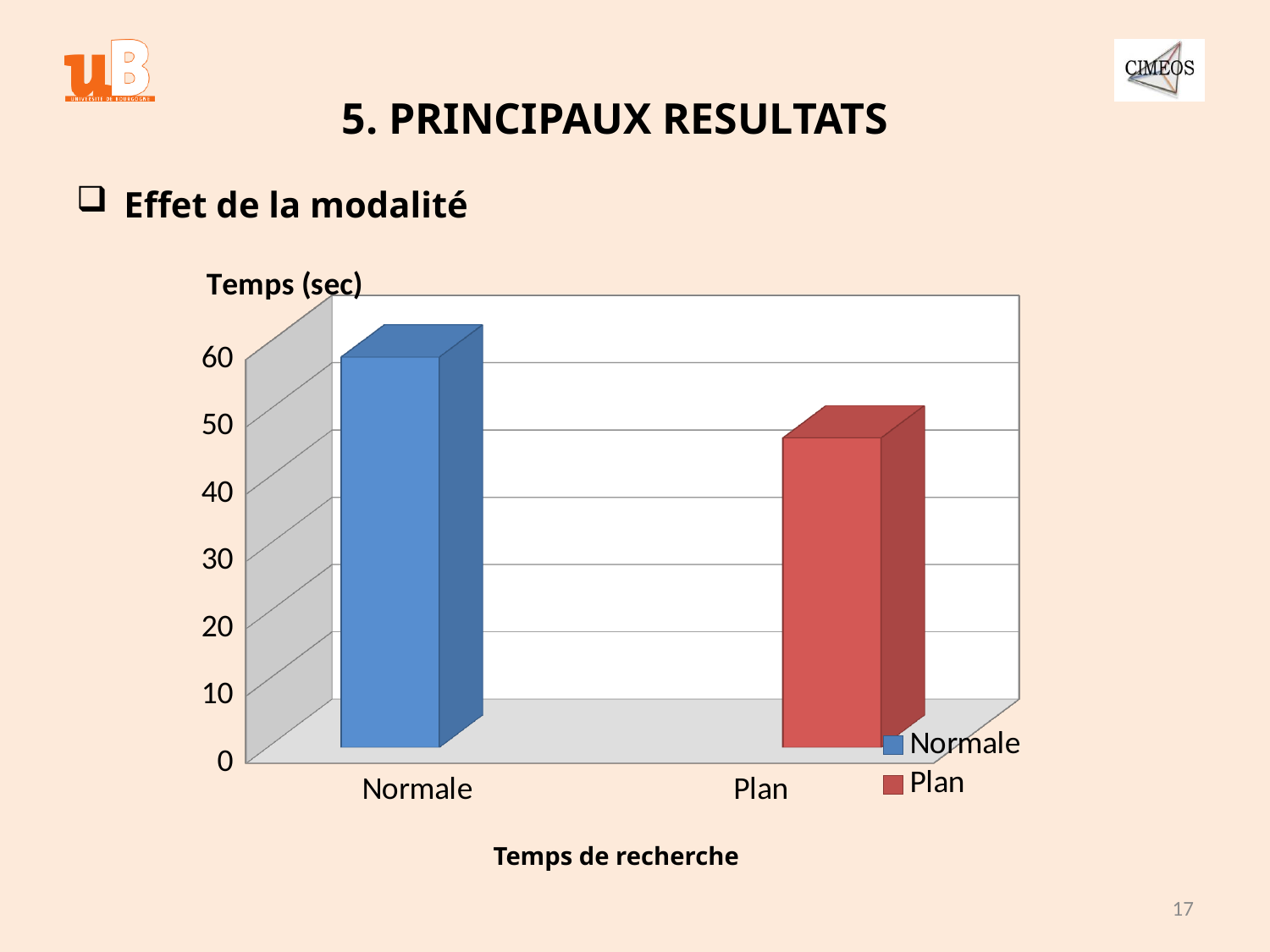
How many bars are plotted in the chart? 2 How many series does the legend list? 2 Is the value for Plan greater or less than 40? greater What kind of chart is shown on the slide? bar chart Which is larger, the value for Normale or the value for Plan? Normale Which category has the highest search time? Normale What is the label of the vertical axis of the chart? Temps (sec) Is the value for Normale greater or less than 50? greater Which category has the lowest search time? Plan What is the label shown below the horizontal axis of the chart? Temps de recherche Is the value for Plan greater or less than 60? less